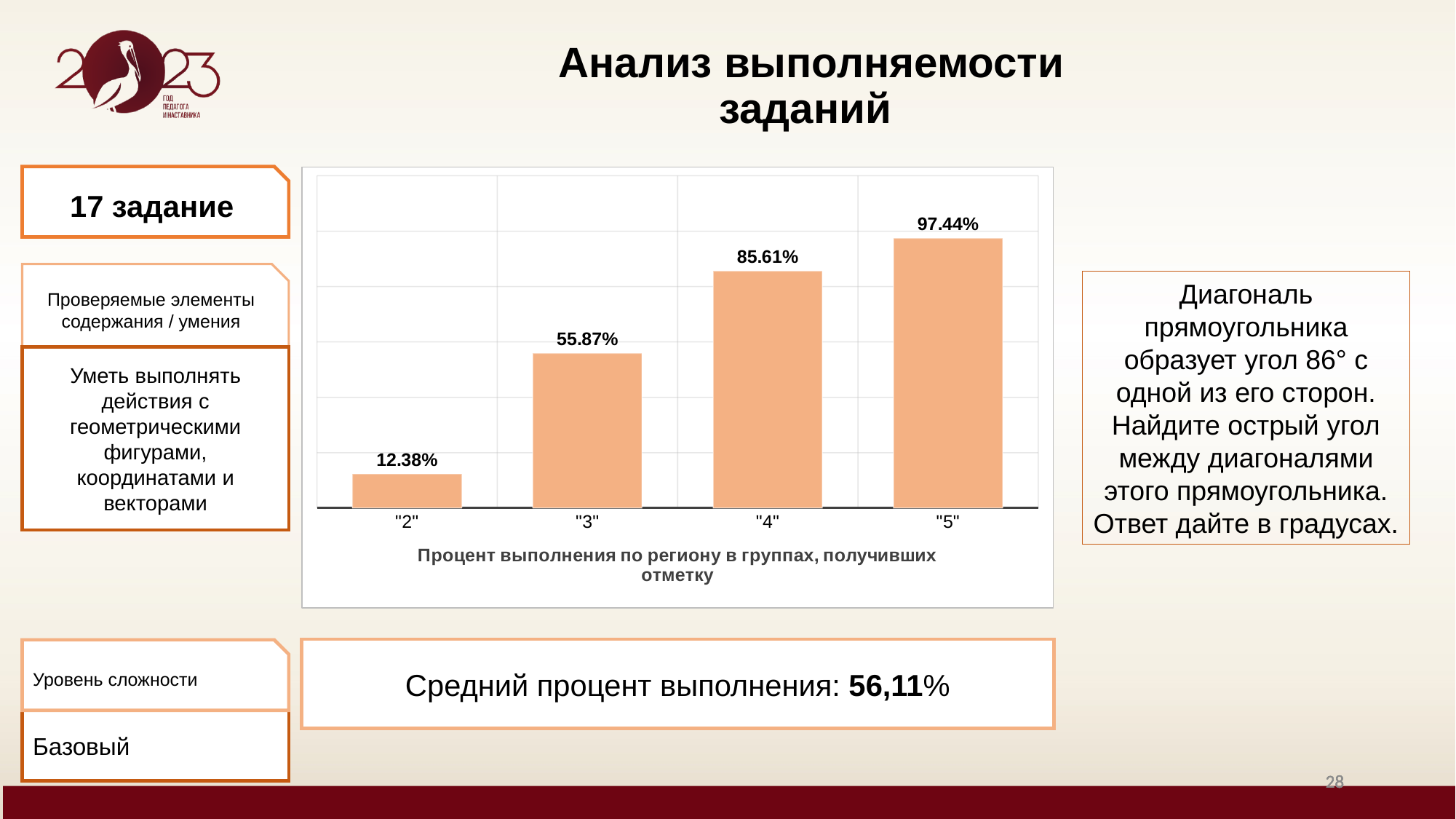
What is the completion percentage for the group with mark "2"? 12.38% What type of chart is shown on the slide? Bar chart What is the completion percentage for the group with mark "5"? 97.44% Which group has a higher completion percentage, "3" or "4"? "4" What is the difference in completion percentage between the "3" group and the "2" group? 43.49% How many mark groups are shown in the chart? 4 Which mark group has the lowest completion percentage? "2" What is the difference in completion percentage between the "5" group and the "4" group? 11.83% Which mark group has the highest completion percentage? "5" Do the completion percentages rise or fall as the mark increases from "2" to "5"? Rise What is the completion percentage for the group with mark "3"? 55.87% What is the completion percentage for the group with mark "4"? 85.61%